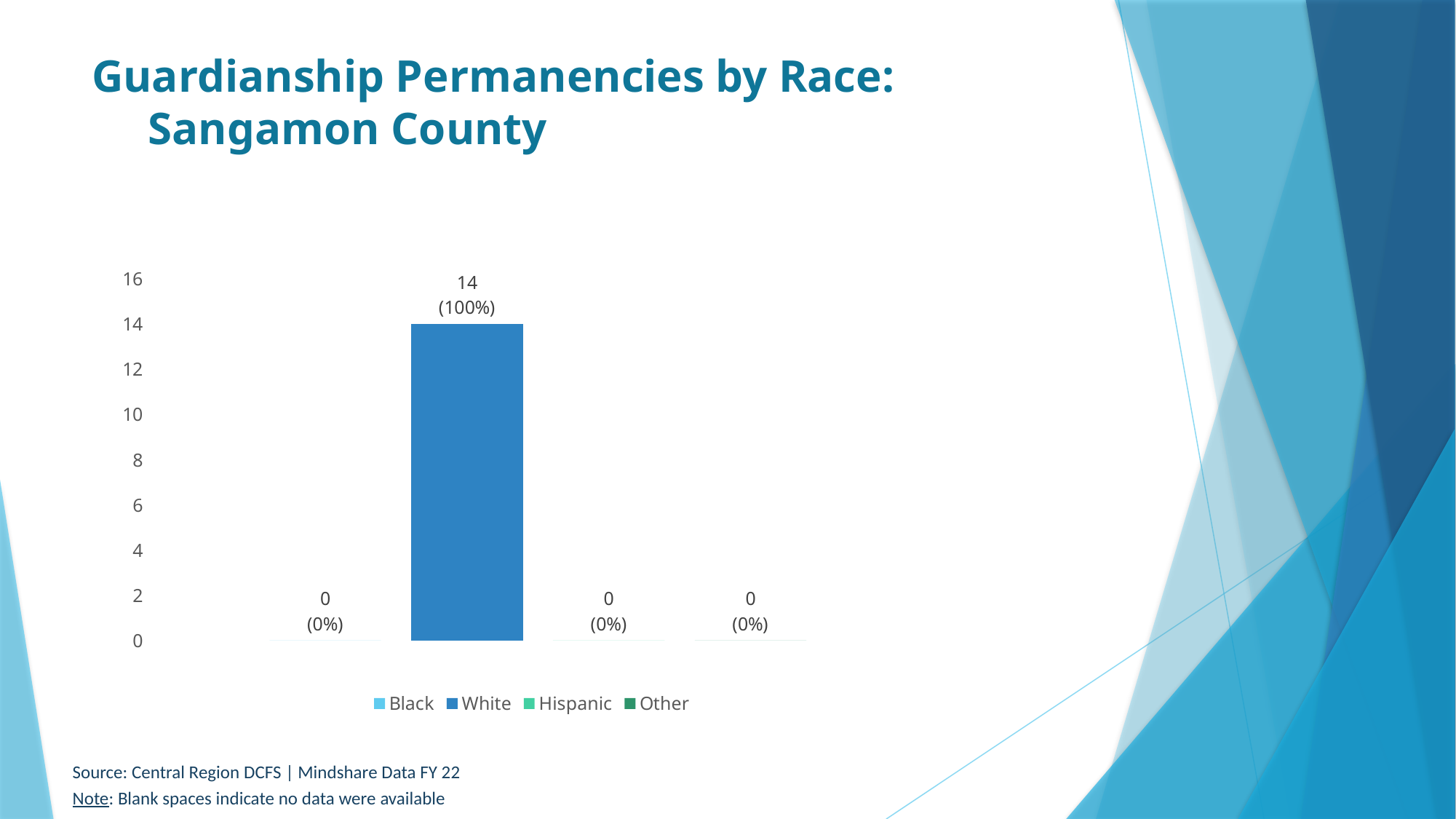
How many series does the legend list? 4 What is the value for Hispanic? 0 What is the title of the slide? Guardianship Permanencies by Race: Sangamon County What percentage is shown for White? 100% What is the total of all the values shown in the chart? 14 Which category has the highest value? White Which is larger, the value for White or the value for Black? White What is the difference between the values for White and Other? 14 Is the value for White greater or less than 10? greater What is the value for Black? 0 What is the value for White? 14 What kind of chart is shown on the slide? bar chart